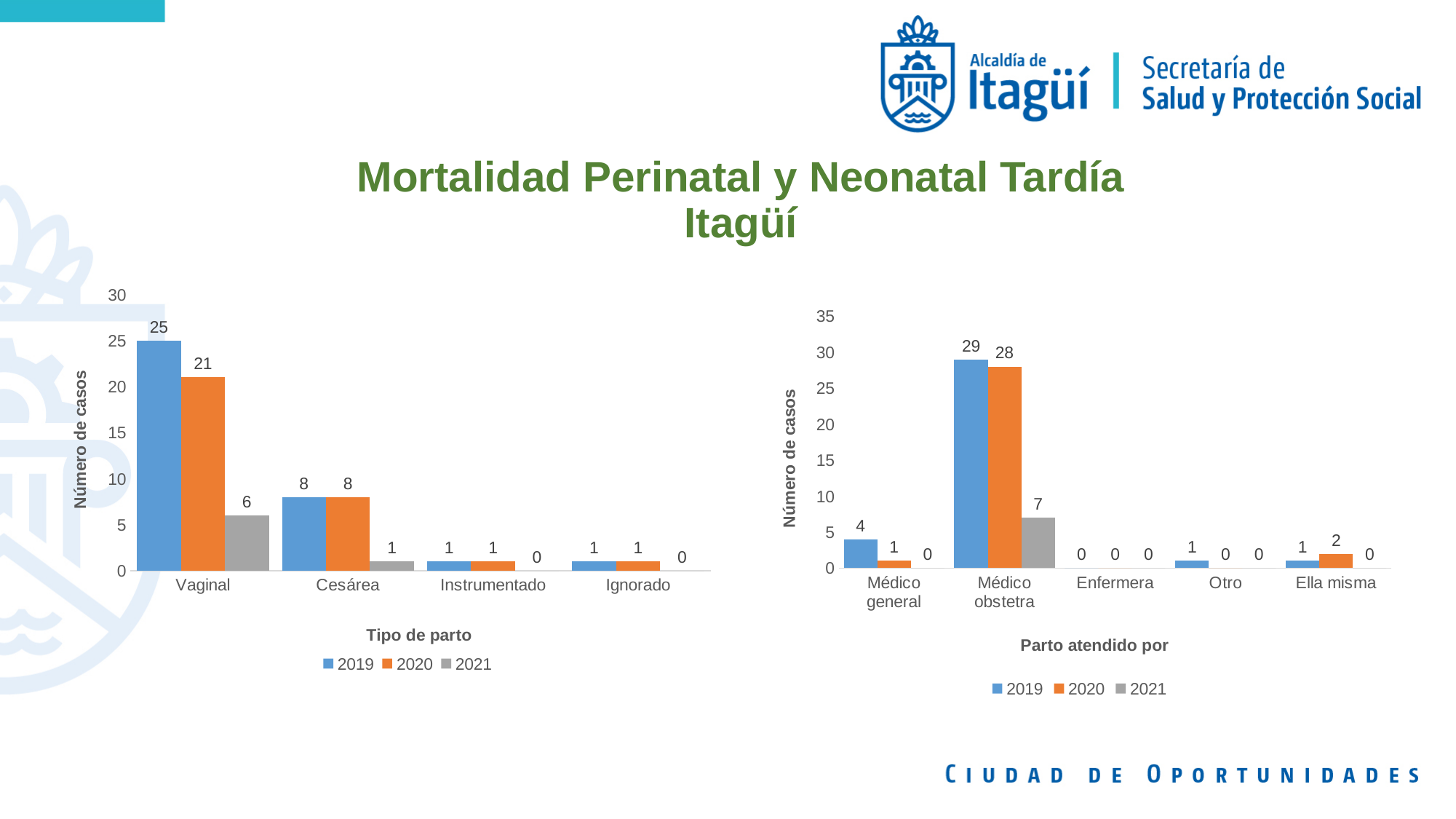
In the left chart (Tipo de parto), how many categories are shown on the x axis? 4 In the right chart (Parto atendido por), what is the difference between the 2019 and 2021 values for Médico obstetra? 22 In the right chart (Parto atendido por), what is the value for Médico general in 2019? 4 In the left chart (Tipo de parto), what is the difference between the 2019 and 2020 values for Vaginal? 4 In the left chart (Tipo de parto), what is the value for Cesárea in 2021? 1 In the right chart (Parto atendido por), which category has the highest value for 2021? Médico obstetra In the right chart (Parto atendido por), what is the value for Médico obstetra in 2020? 28 In the left chart (Tipo de parto), what is the value for Vaginal in 2019? 25 What kind of chart is the right chart (Parto atendido por)? Bar chart In the left chart (Tipo de parto), how many series does the legend list? 3 In the left chart (Tipo de parto), which category has the highest value for 2020? Vaginal In the right chart (Parto atendido por), which is larger: the 2019 value for Médico obstetra or the 2020 value for Médico obstetra? 2019